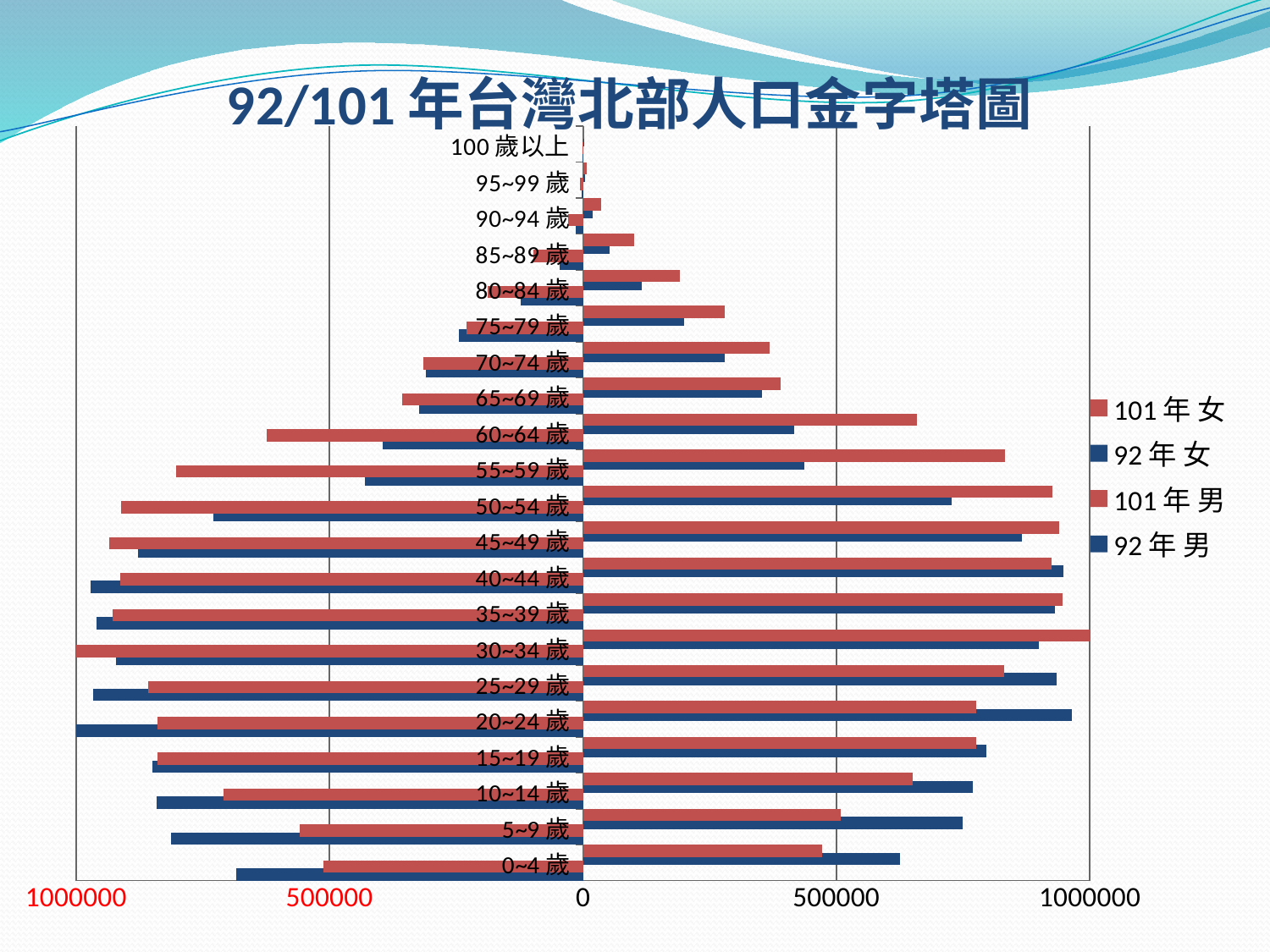
What is the title of the chart? 92/101 年台灣北部人口金字塔圖 Is the value for 92 年 女 in the 60~64 歲 group greater or less than 500000? less Which series is listed first in the legend? 101 年 女 How many age groups are shown on the chart? 21 Which age group has the highest value for 101 年 女? 30~34 歲 How many series does the legend list? 4 What kind of chart is shown on the slide? bar chart For the 55~59 歲 group, which is larger: 101 年 男 or 92 年 男? 101 年 男 Is the value for 101 年 女 in the 55~59 歲 group greater or less than 500000? greater Is the value for 92 年 女 in the 0~4 歲 group greater or less than 500000? greater Do the 101 年 女 values rise or fall from the 60~64 歲 group up to the 100 歲以上 group? fall